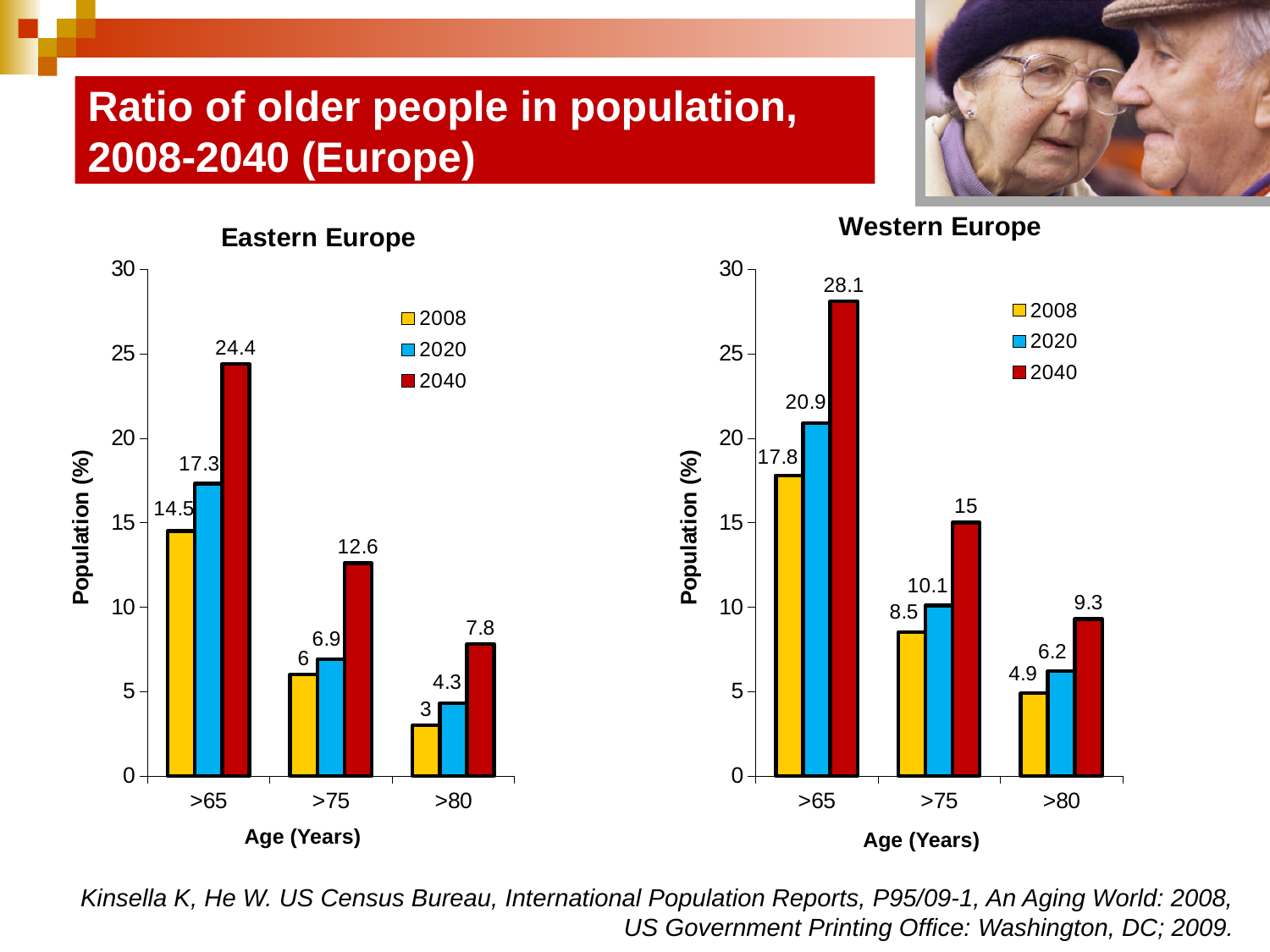
In the Eastern Europe chart, do the 2040 values rise or fall as the age group increases from >65 to >80? Fall How many series does the legend of the Western Europe chart list? 3 In the Eastern Europe chart, what is the value for the >65 age group in 2040? 24.4 In the Western Europe chart, what is the difference between the 2020 and 2008 values for the >65 age group? 3.1 In the Western Europe chart, is the 2040 value for the >65 age group greater or less than 25? greater How many age groups are shown on the x axis of the Eastern Europe chart? 3 Which is larger: the 2020 value for >80 in the Eastern Europe chart or the 2020 value for >80 in the Western Europe chart? Western Europe In the Eastern Europe chart, which age group has the lowest value for 2008? >80 In the Eastern Europe chart, what is the difference between the 2040 and 2008 values for the >75 age group? 6.6 In the Western Europe chart, what is the value for the >75 age group in 2008? 8.5 In the Western Europe chart, which age group has the highest value for 2040? >65 What kind of chart is the Eastern Europe chart? Bar chart